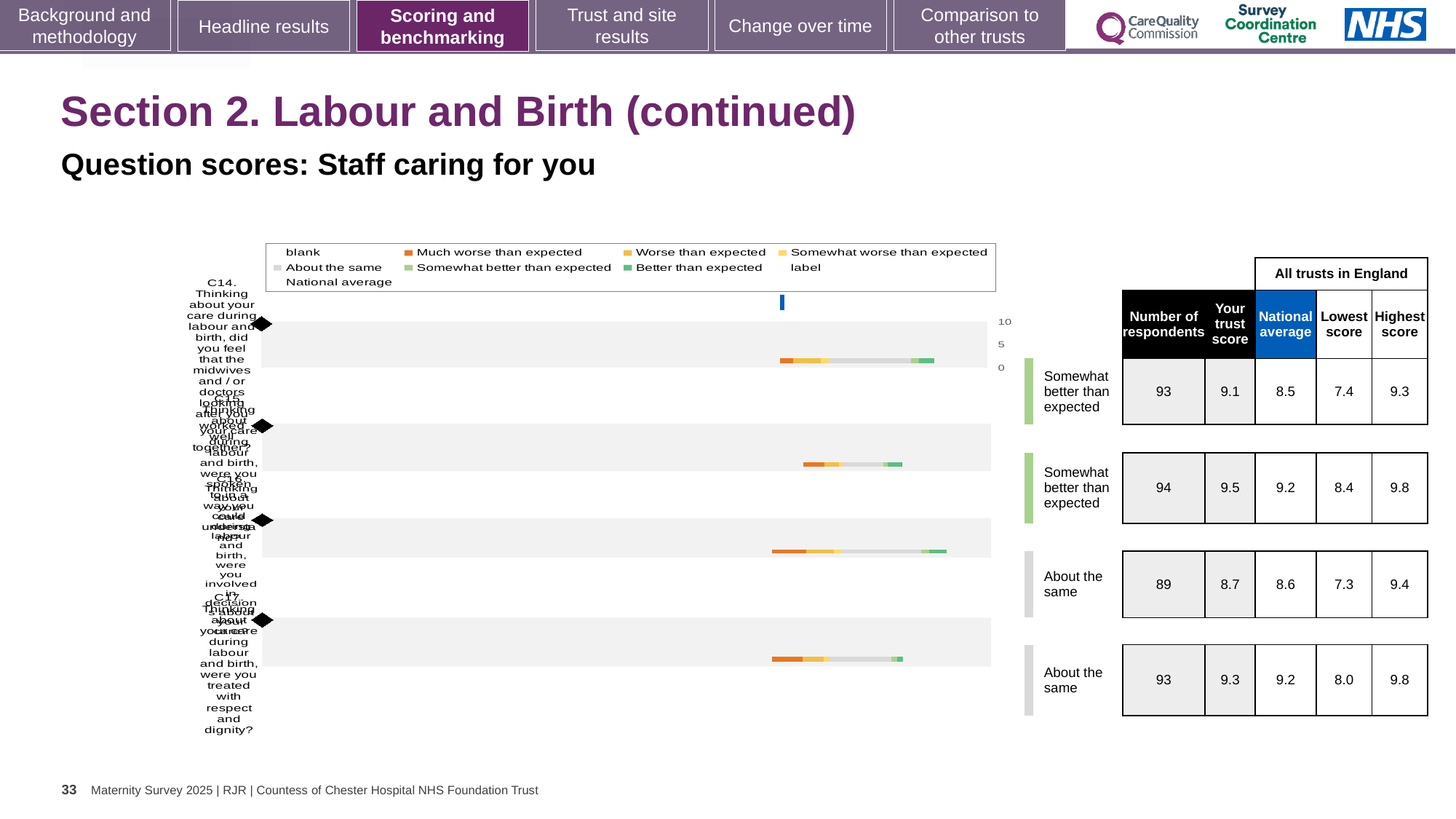
How many question rows (categories) are plotted in the chart? 4 In the table beside the chart, what is the difference between the trust score and the national average for the first row (C14)? 0.6 What is the highest tick value shown on the chart's axis? 10 In the table beside the chart, what is the highest score for the fourth row (C17)? 9.8 Which colour does the legend use for 'Much worse than expected'? orange In the table beside the chart, which row has the highest 'Your trust score'? the second row (C15), 9.5 In the table beside the chart, how many respondents are listed for the second row (C15)? 94 In the table beside the chart, what is the national average for the third row (C16)? 8.6 How many entries does the chart legend list? 9 In the table beside the chart, what is the 'Your trust score' for the first row (C14)? 9.1 In the table beside the chart, is the trust score for the third row (C16) higher or lower than its national average? higher What kind of chart is shown on the slide? bar chart